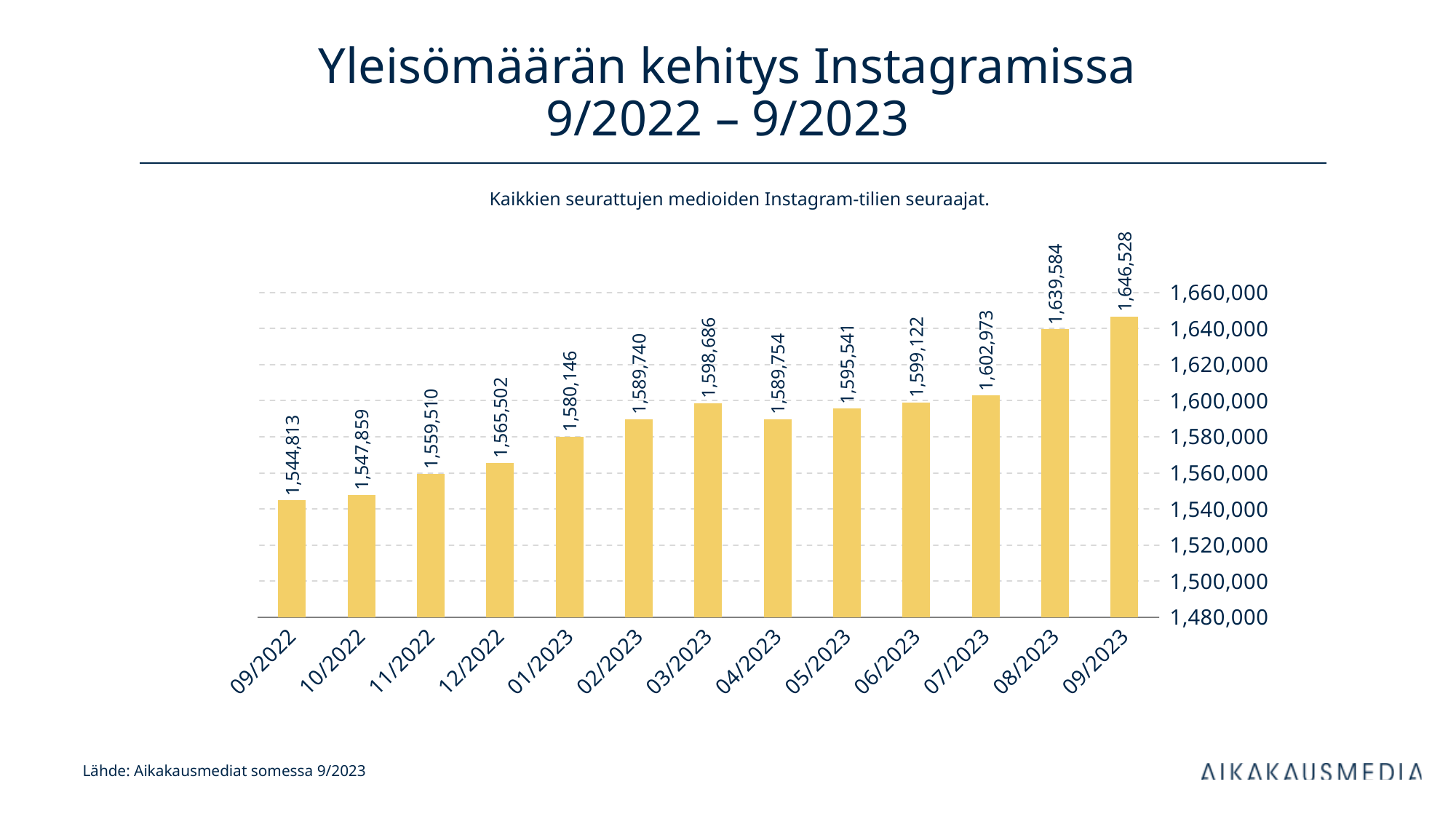
What is the difference between the values for 09/2023 and 09/2022? 101,715 What kind of chart is shown on the slide? bar chart Which month has the lowest value? 09/2022 What is the value for 08/2023? 1,639,584 How many months are shown on the x axis? 13 Is the value for 12/2022 greater or less than 1,580,000? less What is the difference between the values for 08/2023 and 07/2023? 36,611 Which is larger, the value for 03/2023 or the value for 04/2023? 03/2023 Which month has the highest value? 09/2023 What is the value for 09/2022? 1,544,813 Do the values generally rise or fall from 09/2022 to 09/2023? rise What is the value for 03/2023? 1,598,686